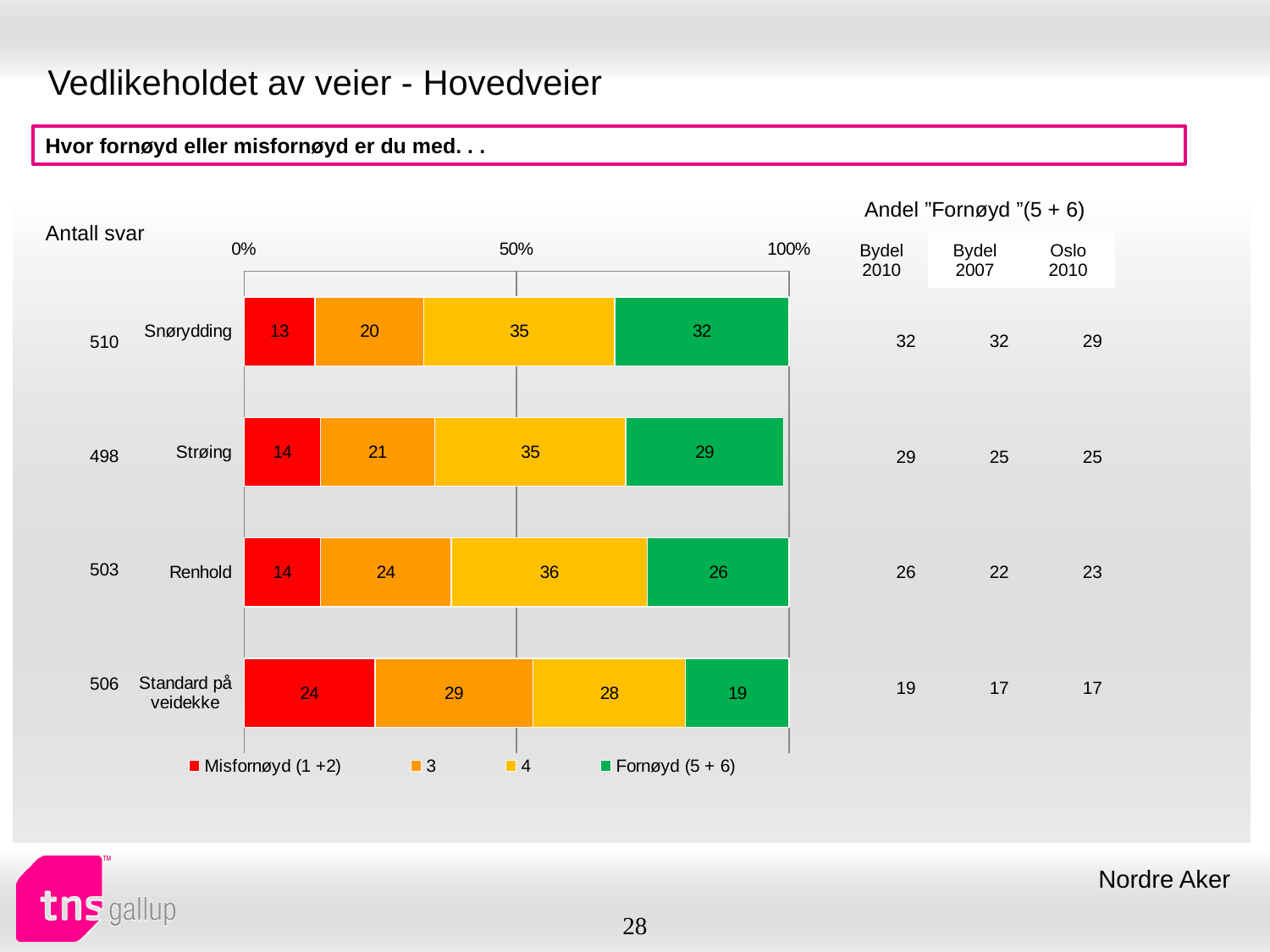
Which category has the lowest Fornøyd (5 + 6) value? Standard på veidekke What is the value of series 3 for Strøing? 21 What kind of chart is shown on the slide? stacked bar chart What is the Fornøyd (5 + 6) value for Snørydding? 32 What is the difference between the Misfornøyd (1 +2) values for Standard på veidekke and Snørydding? 11 What is the Misfornøyd (1 +2) value for Standard på veidekke? 24 What is the value of series 4 for Renhold? 36 How many categories are plotted in the chart? 4 Which category has the highest Fornøyd (5 + 6) value? Snørydding Which is larger: the series 3 value for Renhold or the series 3 value for Snørydding? Renhold How many series does the chart legend list? 4 What is the total of the stacked bar for Strøing? 99